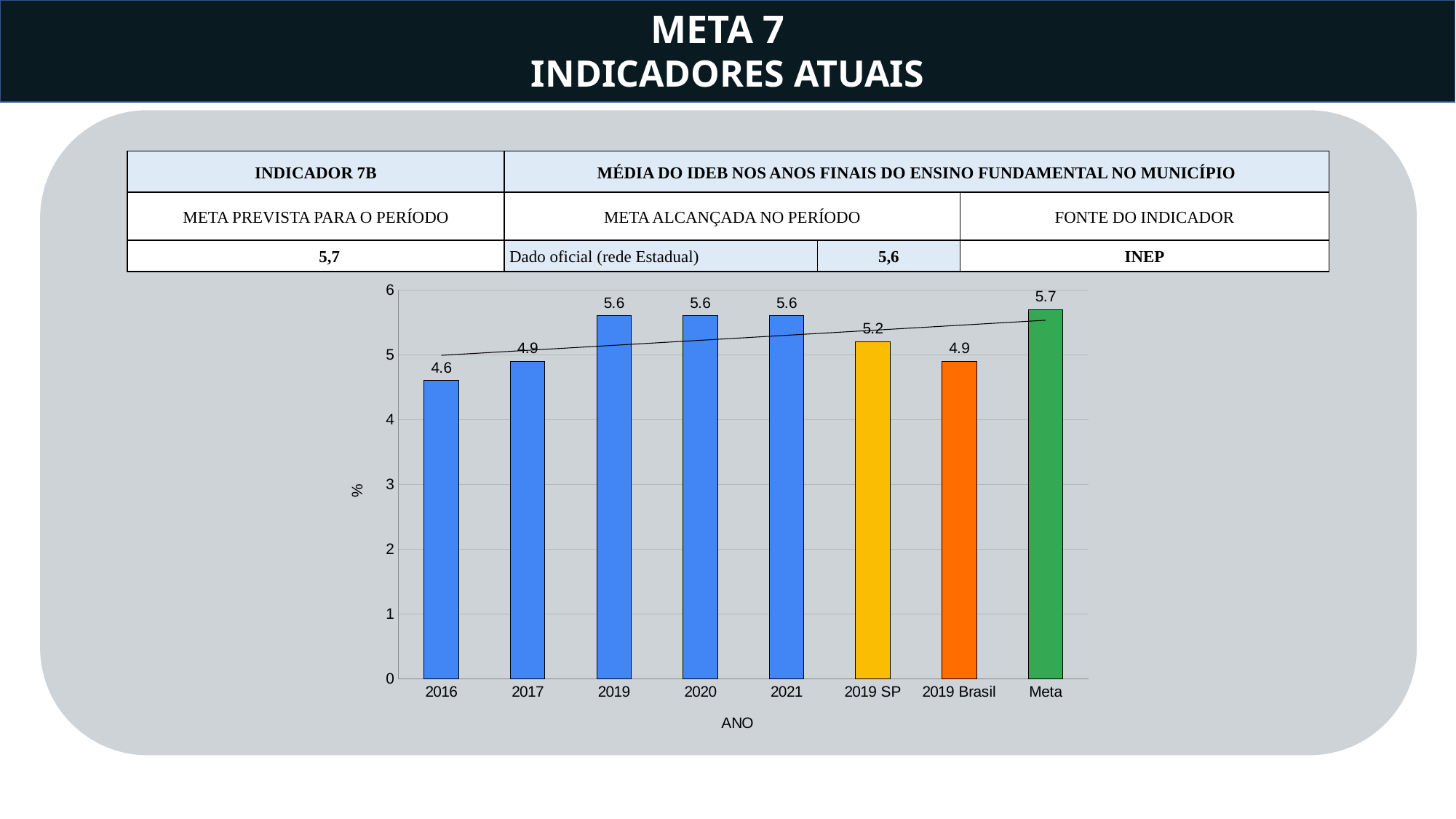
What is the value for 2019 SP? 5.2 What is the value for Meta? 5.7 What is the difference between the value for 2019 and the value for 2016? 1.0 Which category has the lowest value? 2016 Which category has the highest value? Meta What is the label of the x axis? ANO What is the difference between the value for Meta and the value for 2021? 0.1 What kind of chart is shown on the slide? Bar chart Which is larger, the value for 2019 SP or the value for 2019 Brasil? 2019 SP How many bars are shown in the chart? 8 What is the value for 2016? 4.6 What is the value for 2019 Brasil? 4.9